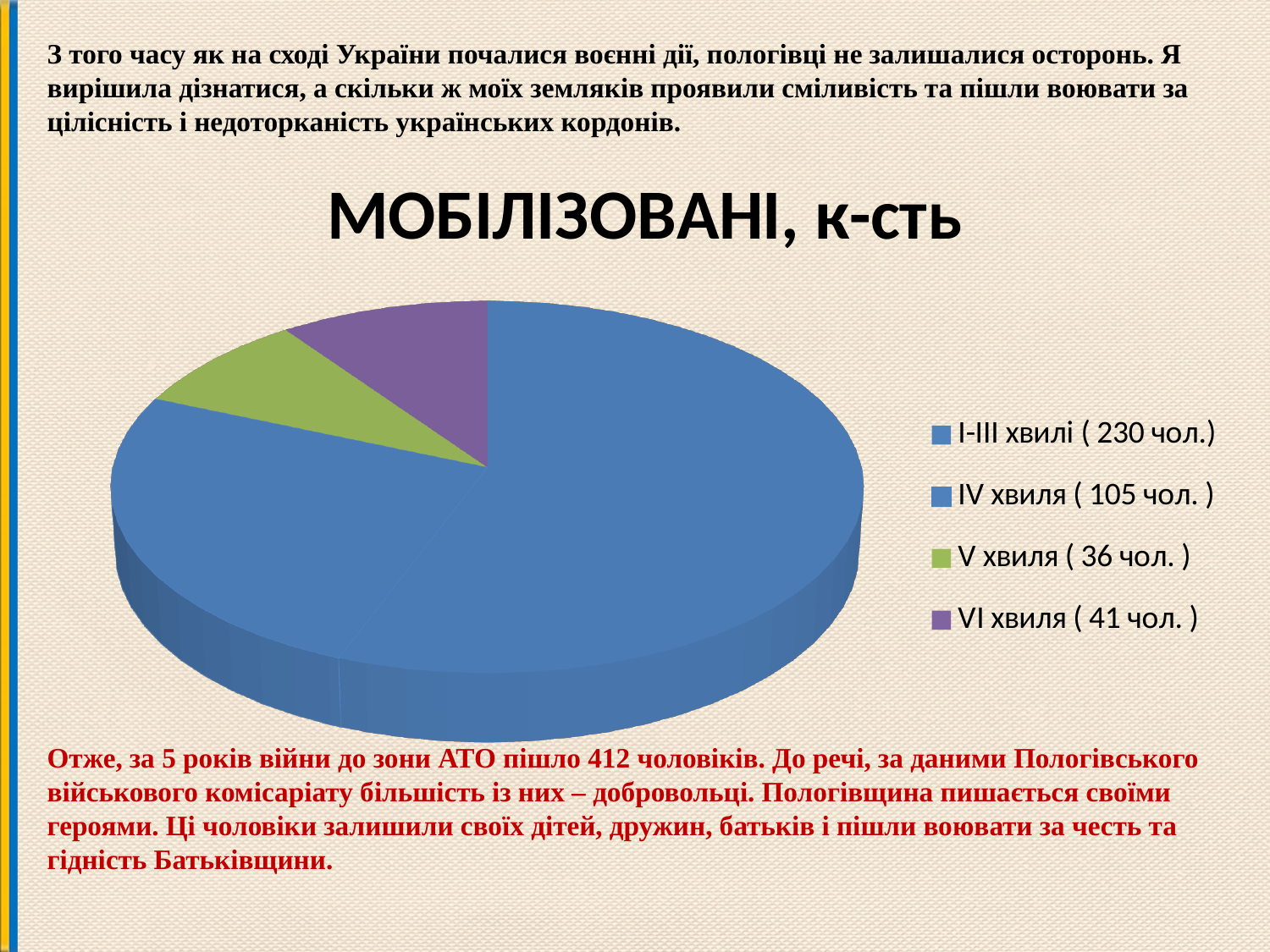
How many people are shown for VI хвиля? 41 чол. How many people are shown for I-III хвилі? 230 чол. What is the difference between I-III хвилі and IV хвиля? 125 How many people are shown for V хвиля? 36 чол. How many people are shown for IV хвиля? 105 чол. Which category has the largest value? I-III хвилі How many categories does the pie chart have? 4 What kind of chart is shown on the slide? pie chart What is the title of the chart? МОБІЛІЗОВАНІ, к-сть What is the total of all four categories in the pie chart? 412 Which is larger, V хвиля or VI хвиля? VI хвиля Which category has the smallest value? V хвиля